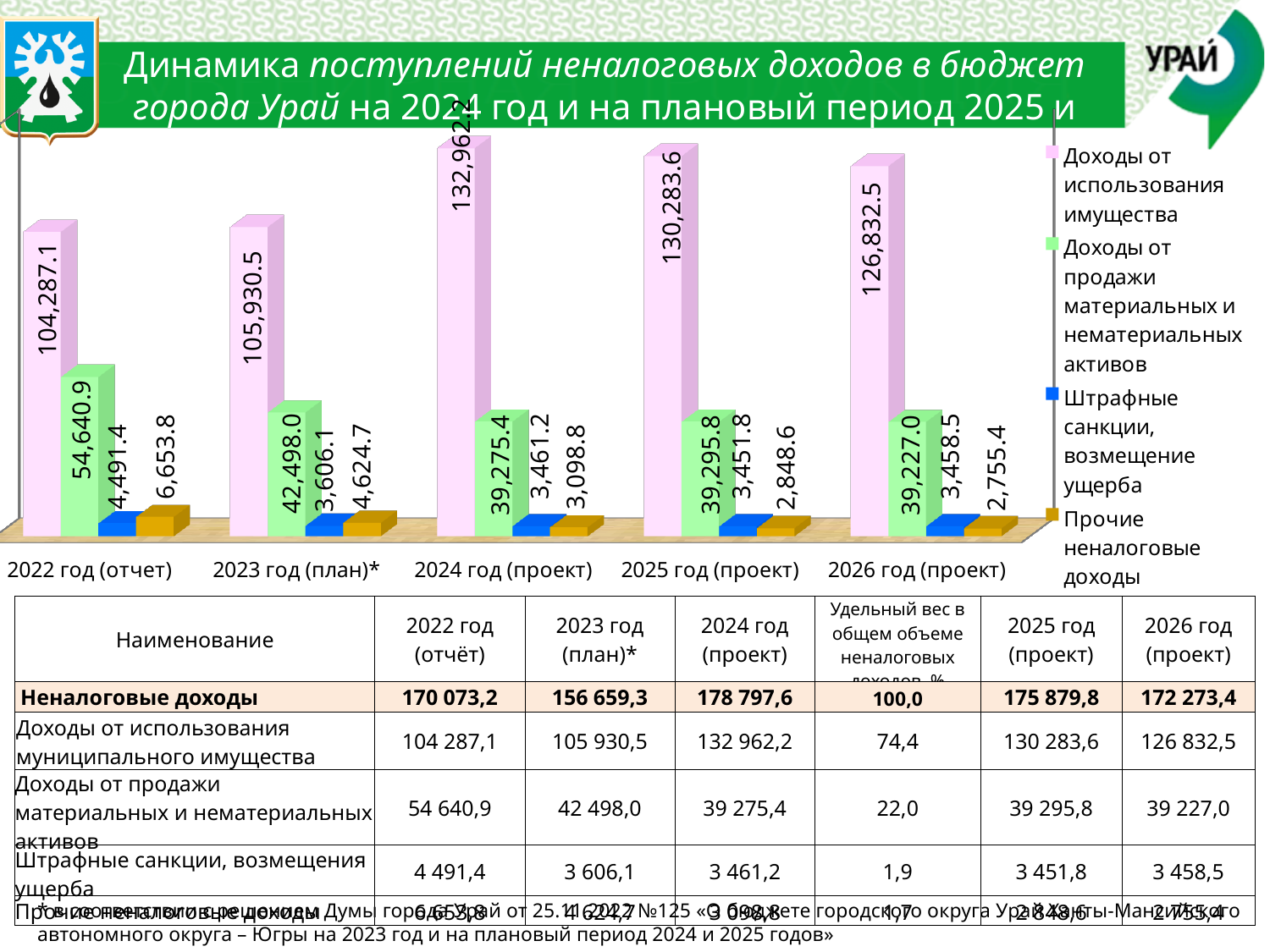
How many year categories are shown on the x axis of the chart? 5 What is the value of Доходы от использования имущества for 2024 год (проект)? 132,962.2 In which year is Доходы от использования имущества lowest? 2022 год (отчет) Does Прочие неналоговые доходы rise or fall from 2022 год (отчет) to 2026 год (проект)? fall What is the value of Прочие неналоговые доходы for 2026 год (проект)? 2,755.4 What is the value of Доходы от продажи материальных и нематериальных активов for 2022 год (отчет)? 54,640.9 What is the value of Штрафные санкции, возмещение ущерба for 2023 год (план)*? 3,606.1 In 2022 год (отчет), which is larger: Штрафные санкции, возмещение ущерба or Прочие неналоговые доходы? Прочие неналоговые доходы What is the difference between Доходы от использования имущества in 2024 год (проект) and 2025 год (проект)? 2,678.6 How many series does the chart legend list? 4 What is the difference between Доходы от продажи материальных и нематериальных активов in 2022 год (отчет) and 2023 год (план)*? 12,142.9 In which year is Доходы от использования имущества highest? 2024 год (проект)